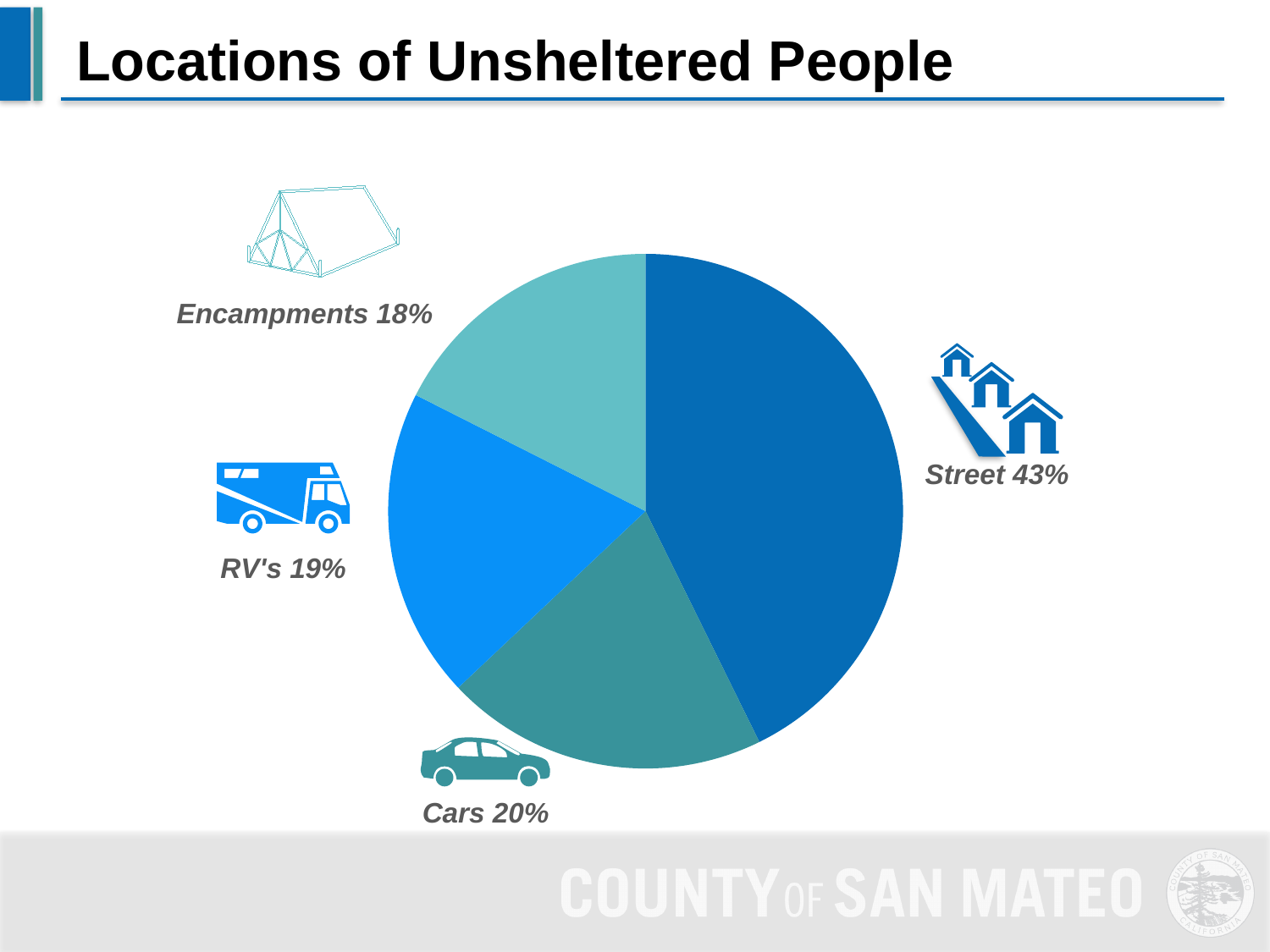
What is the difference in percentage points between RV's and Encampments? 1 How many location categories does the pie chart show? 4 Which location has the smallest share of unsheltered people? Encampments Which location has the largest share of unsheltered people? Street Which is larger, the share for Street or the share for RV's? Street What kind of chart is shown on the slide? pie chart What is the difference in percentage points between Street and Cars? 23 What share of unsheltered people are located on the street? 43% What percentage of unsheltered people are in RV's? 19% What percentage of unsheltered people are in cars? 20% What percentage of unsheltered people are in encampments? 18% What is the title of the slide containing the pie chart? Locations of Unsheltered People